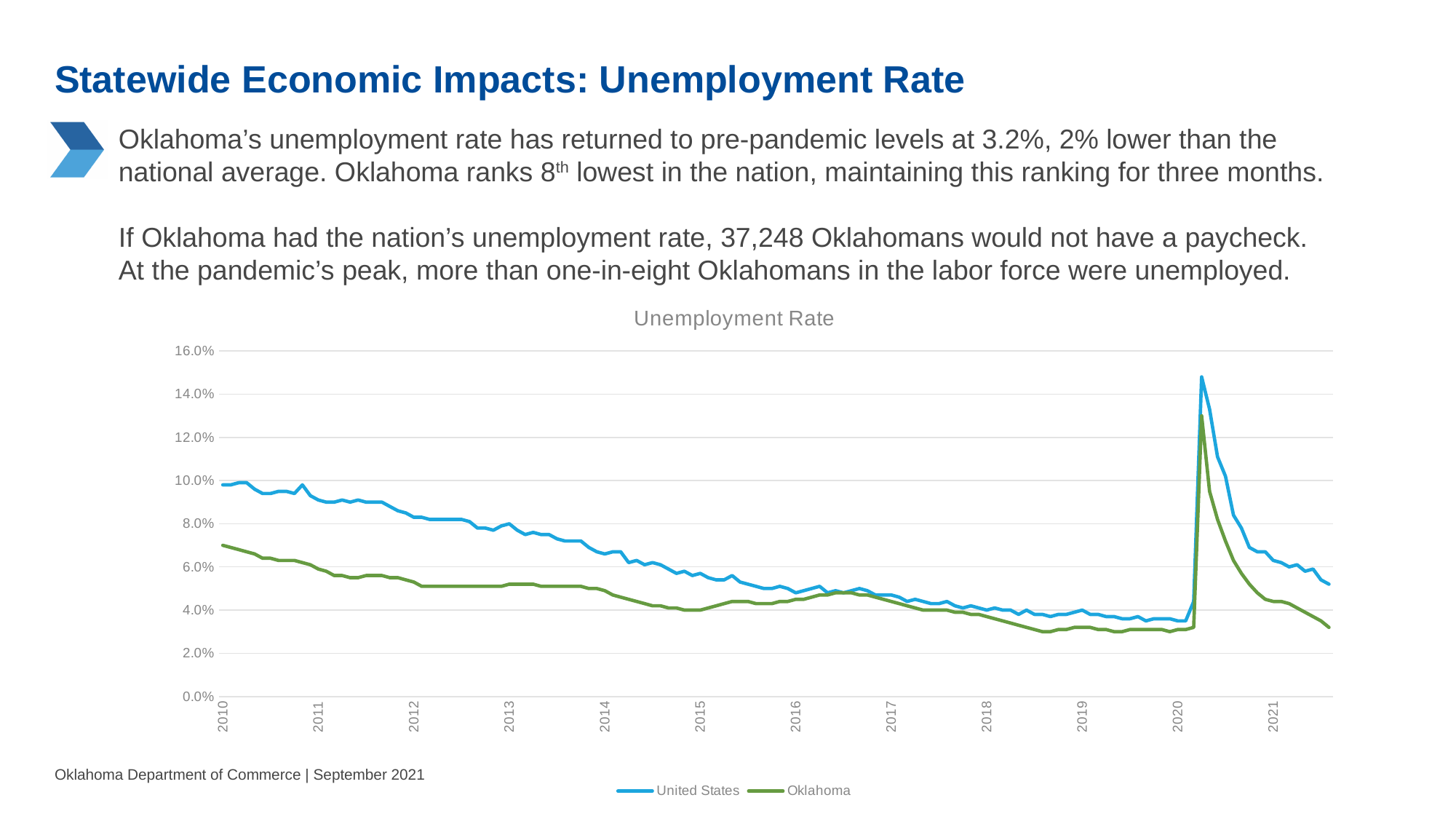
How many year labels are shown on the x axis of the chart? 12 What is the title of the chart? Unemployment Rate Which two series are listed in the chart's legend? United States and Oklahoma Which series reaches the higher peak in 2020, United States or Oklahoma? United States Does the United States unemployment rate generally rise or fall from 2010 to 2019? fall Is the Oklahoma unemployment rate at the end of the series in 2021 greater or less than 4.0%? less Is the Oklahoma unemployment rate during 2019 greater or less than 4.0%? less How many series does the legend of the chart list? 2 What kind of chart is shown on the slide? line chart Is the peak United States unemployment rate in 2020 greater or less than 14.0%? greater At the start of 2010, which series has the higher unemployment rate, United States or Oklahoma? United States